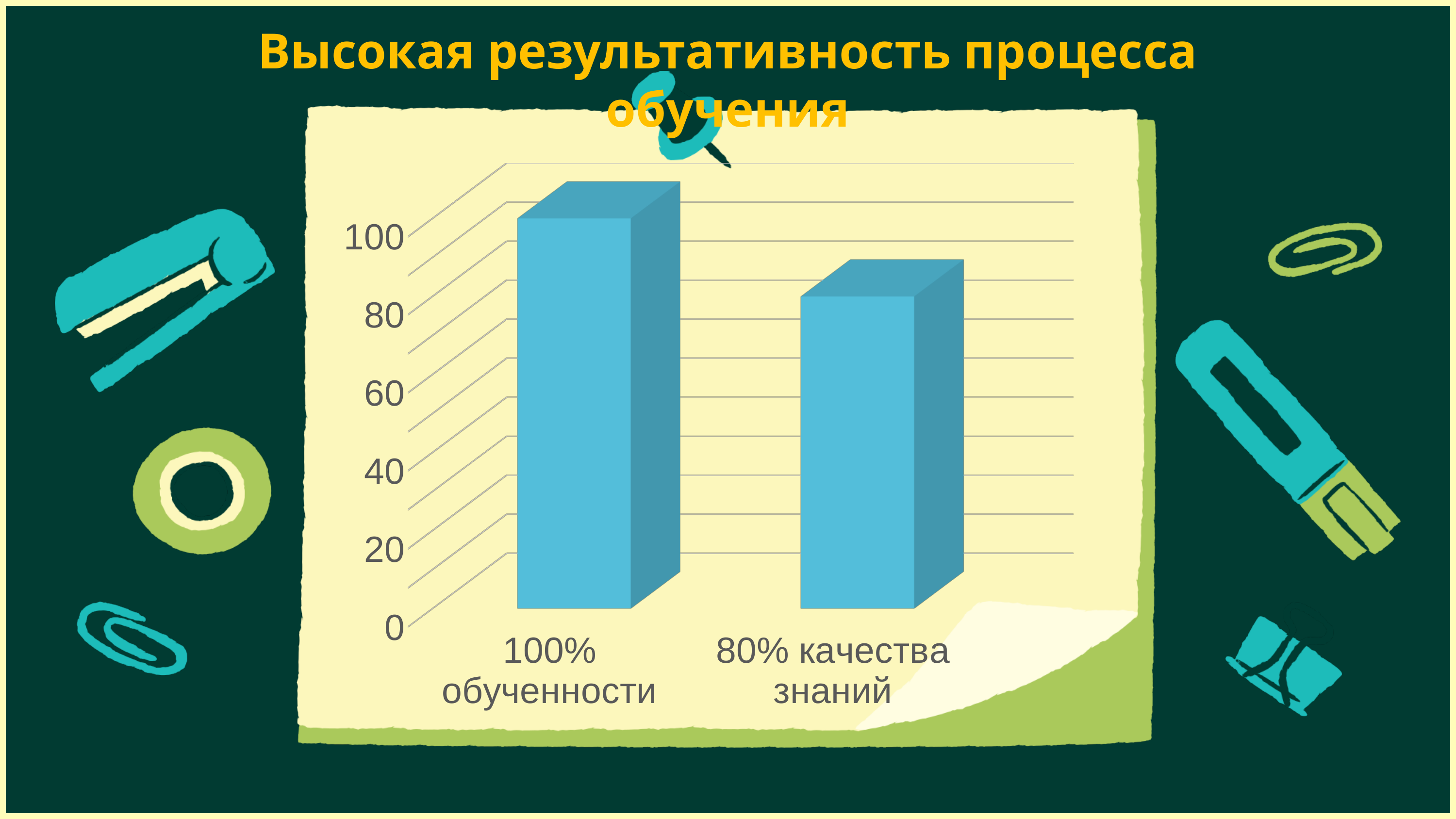
What is the highest tick label shown on the vertical axis? 100 Which category has the highest bar? 100% обученности Is the value for "80% качества знаний" greater or less than 100? less Is the value for "80% качества знаний" greater or less than 60? greater Which bar is taller: "100% обученности" or "80% качества знаний"? 100% обученности Which category has the lowest bar? 80% качества знаний Is the value for "100% обученности" greater or less than 80? greater What kind of chart is shown on the slide? Bar chart How many bars does the chart have? 2 What is the title of the slide containing the chart? Высокая результативность процесса обучения Do the bar values rise or fall from left to right along the x axis? fall